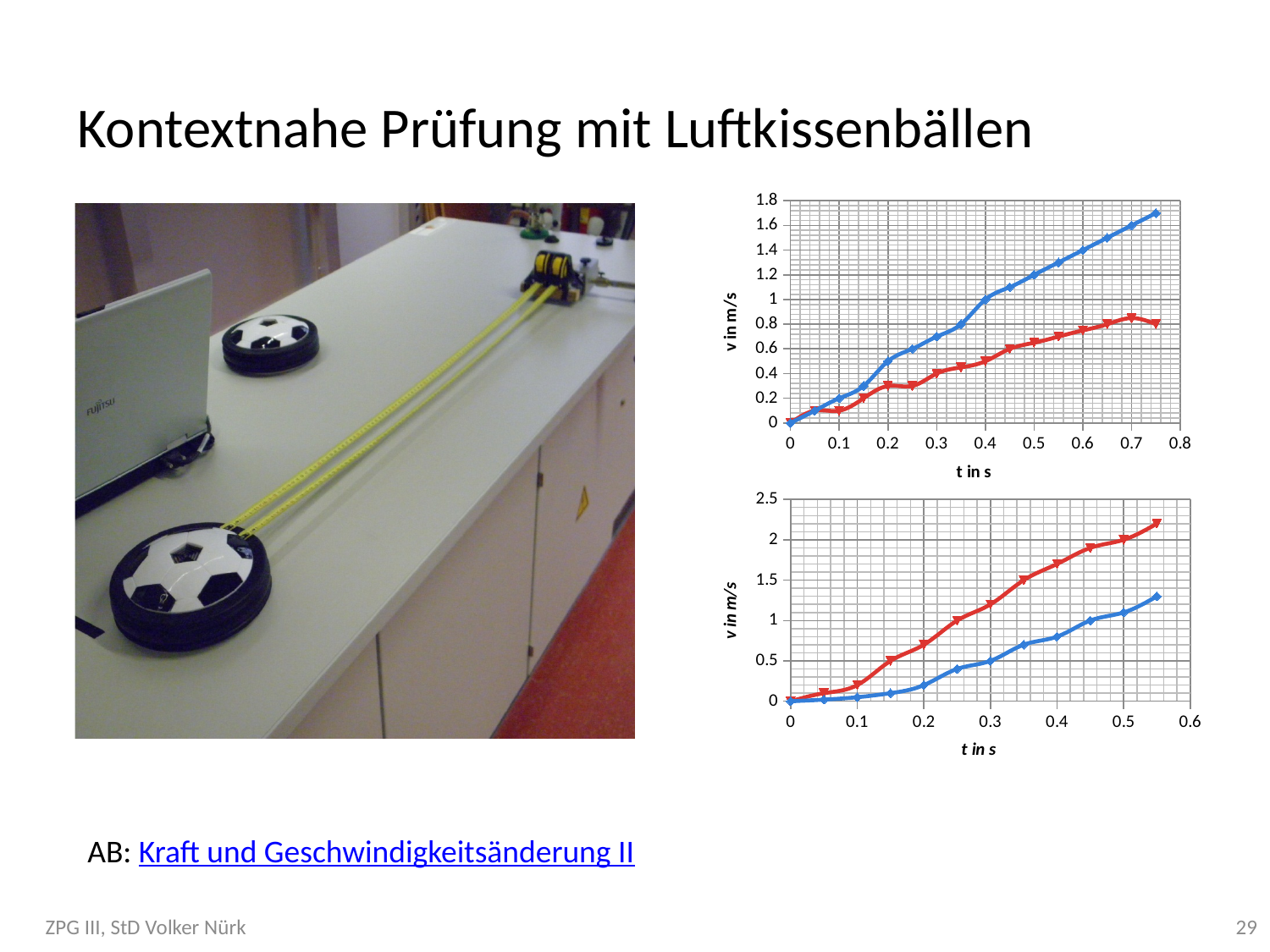
In the top chart, is the value of the blue line at t = 0.75 greater or less than 1.4? greater In the top chart, does the blue line rise or fall as t increases? rise In the bottom chart, is the value of the red line at t = 0.55 greater or less than 2? greater In the top chart, is the value of the red line at t = 0.75 greater or less than 1? less What kind of chart is the top chart on the right of the slide? line chart In the bottom chart, does the red line rise or fall as t increases? rise What is the label of the vertical axis of the bottom chart? v in m/s What is the label of the horizontal axis of the top chart? t in s In the top chart, which line has the larger value at t = 0.5, the blue line or the red line? the blue line In the bottom chart, which line has the larger value at t = 0.4, the blue line or the red line? the red line In the top chart, which line reaches the highest value, the blue line or the red line? the blue line